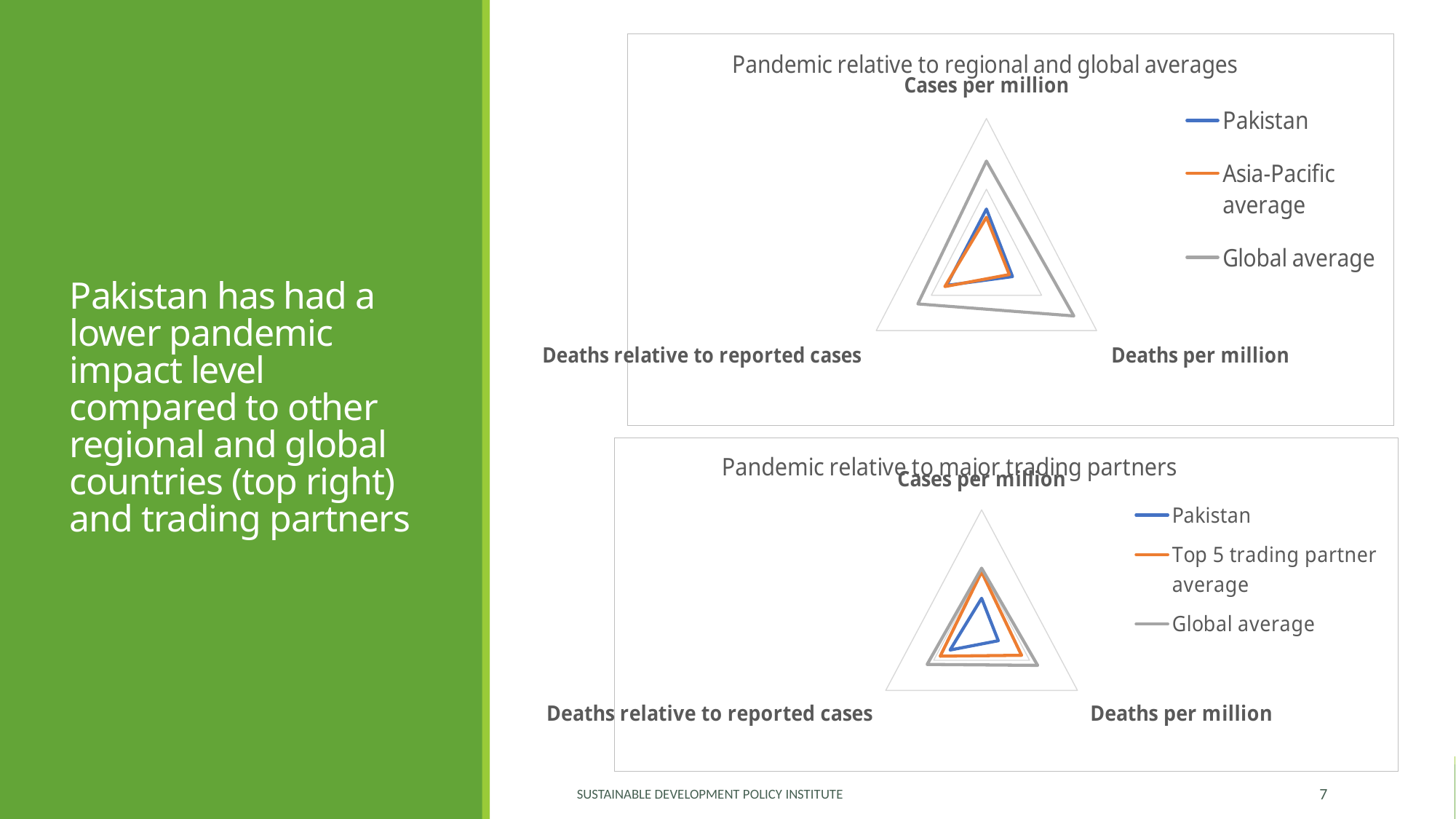
In the top chart 'Pandemic relative to regional and global averages', how many axes (categories) does the radar have? 3 In the bottom chart 'Pandemic relative to major trading partners', how many series does the legend list? 3 What kind of chart is the top chart titled 'Pandemic relative to regional and global averages'? Radar chart In the top chart 'Pandemic relative to regional and global averages', which series is drawn in orange? Asia-Pacific average What kind of chart is the bottom chart titled 'Pandemic relative to major trading partners'? Radar chart In the bottom chart 'Pandemic relative to major trading partners', which series has the lowest value for Deaths per million? Pakistan In the top chart 'Pandemic relative to regional and global averages', which is larger for Cases per million: Pakistan or Global average? Global average In the top chart 'Pandemic relative to regional and global averages', how many series does the legend list? 3 In the bottom chart 'Pandemic relative to major trading partners', how many axes (categories) does the radar have? 3 In the bottom chart 'Pandemic relative to major trading partners', which series has the highest value for Deaths relative to reported cases? Global average In the bottom chart 'Pandemic relative to major trading partners', which is larger for Cases per million: Pakistan or Top 5 trading partner average? Top 5 trading partner average In the top chart 'Pandemic relative to regional and global averages', which series has the highest value for Deaths per million? Global average